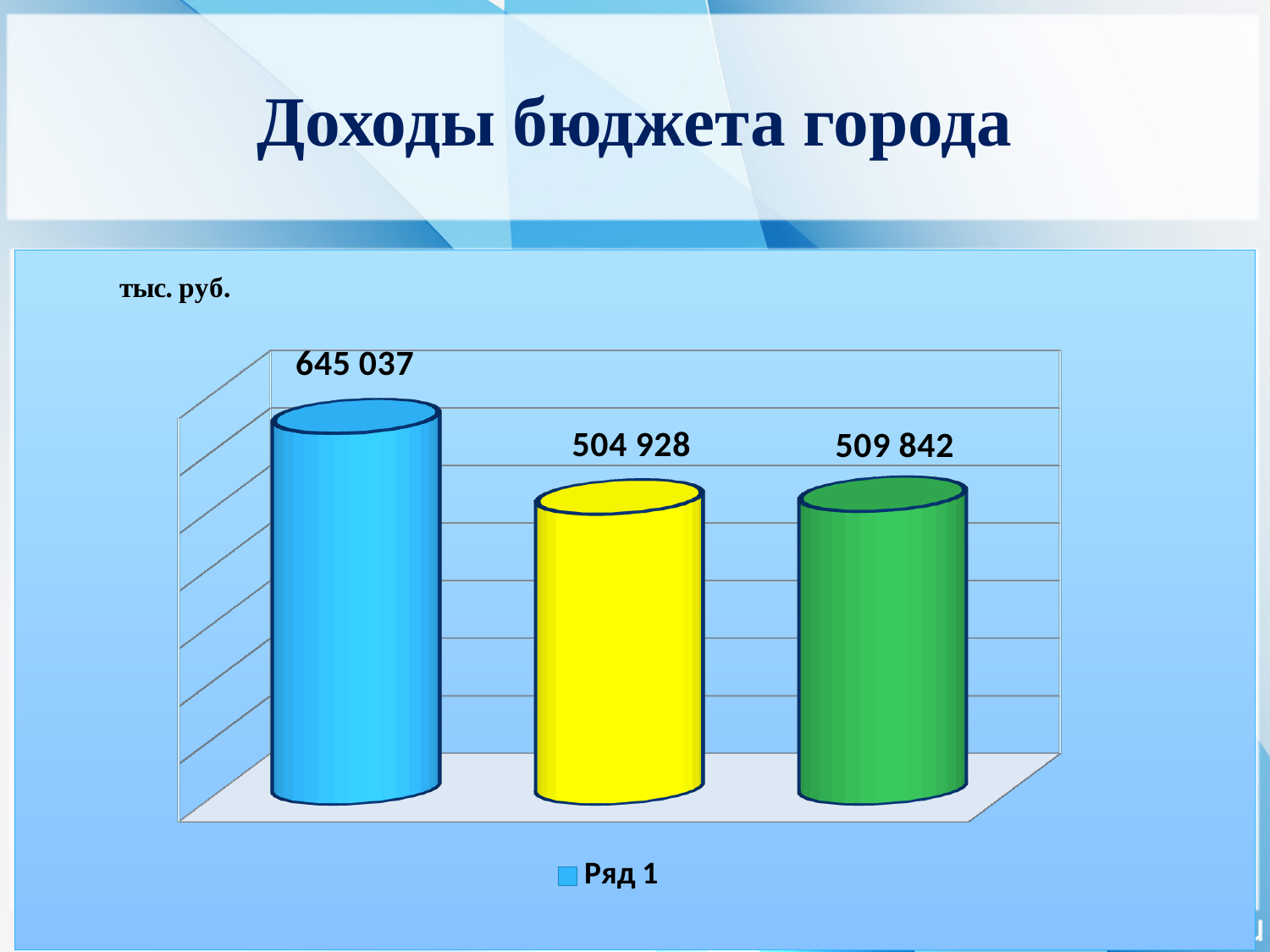
How many series does the legend list? 1 Which bar has the lowest value? The second (yellow) bar, 504 928 What is the value shown on the first (blue) bar? 645 037 What is the value shown on the second (yellow) bar? 504 928 How many bars are plotted in the chart? 3 What is the title of the slide? Доходы бюджета города What kind of chart is shown on the slide? Bar chart What is the difference between the third (green) bar and the second (yellow) bar? 4 914 What is the difference between the first (blue) bar and the second (yellow) bar? 140 109 Which bar has the highest value? The first (blue) bar, 645 037 What is the value shown on the third (green) bar? 509 842 Which is larger, the value of the first (blue) bar or the third (green) bar? The first (blue) bar